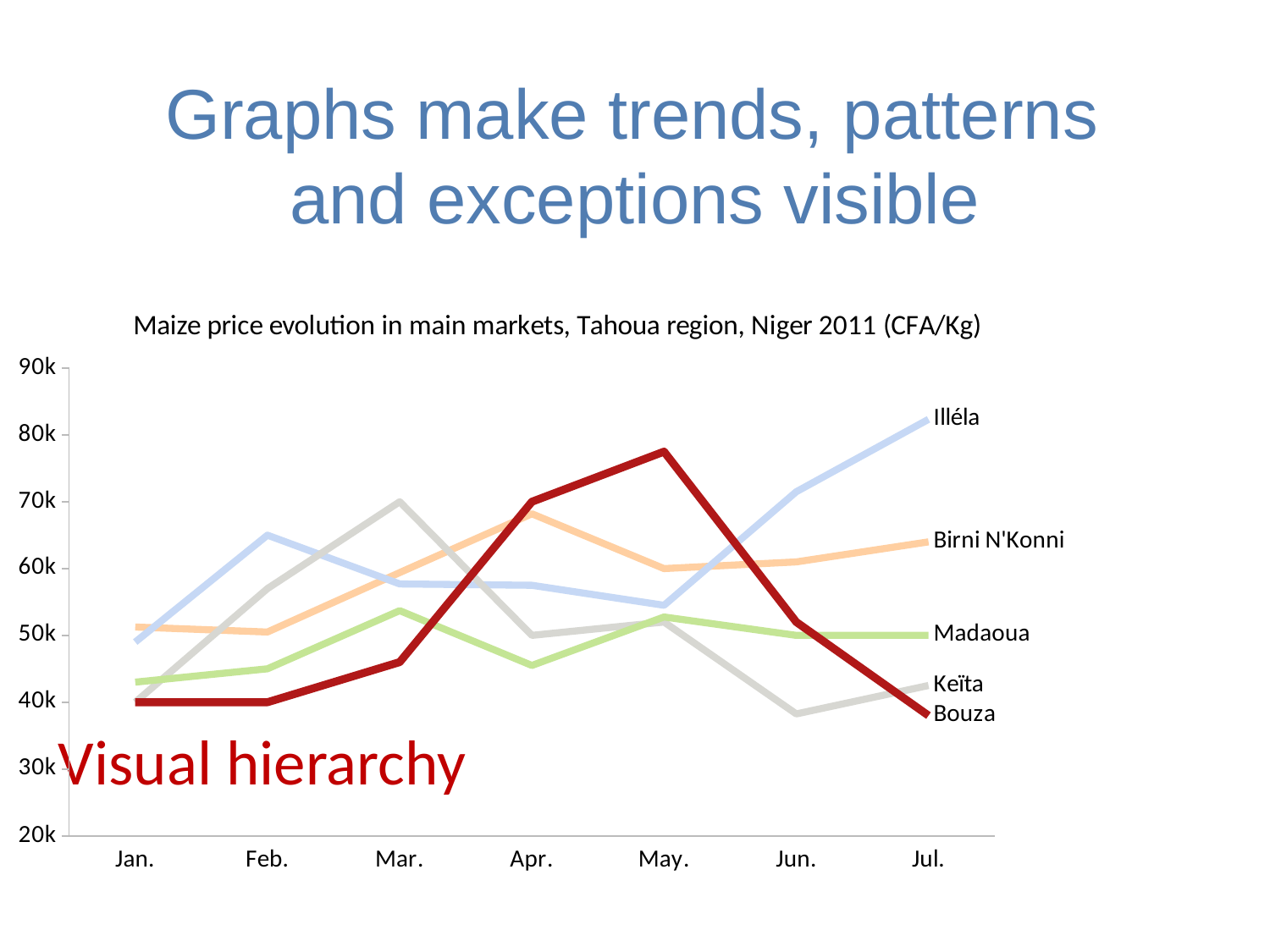
Is the value for Illéla in Jul. greater or less than 80k? greater In Mar., which market has the higher price, Keïta or Madaoua? Keïta Is the value for Keïta in Jun. greater or less than 40k? less Which market has the highest maize price in Jul.? Illéla In which month does the Bouza line reach its highest value? May. How many months are shown along the x axis of the chart? 7 What kind of chart is shown on the slide? line chart Is the value for Bouza in May. greater or less than 70k? greater How many markets (series) are plotted in the chart? 5 Which market has the lowest maize price in Jul.? Bouza Does the Illéla line rise or fall from May. to Jul.? rise Which market is drawn with the thick dark red line? Bouza